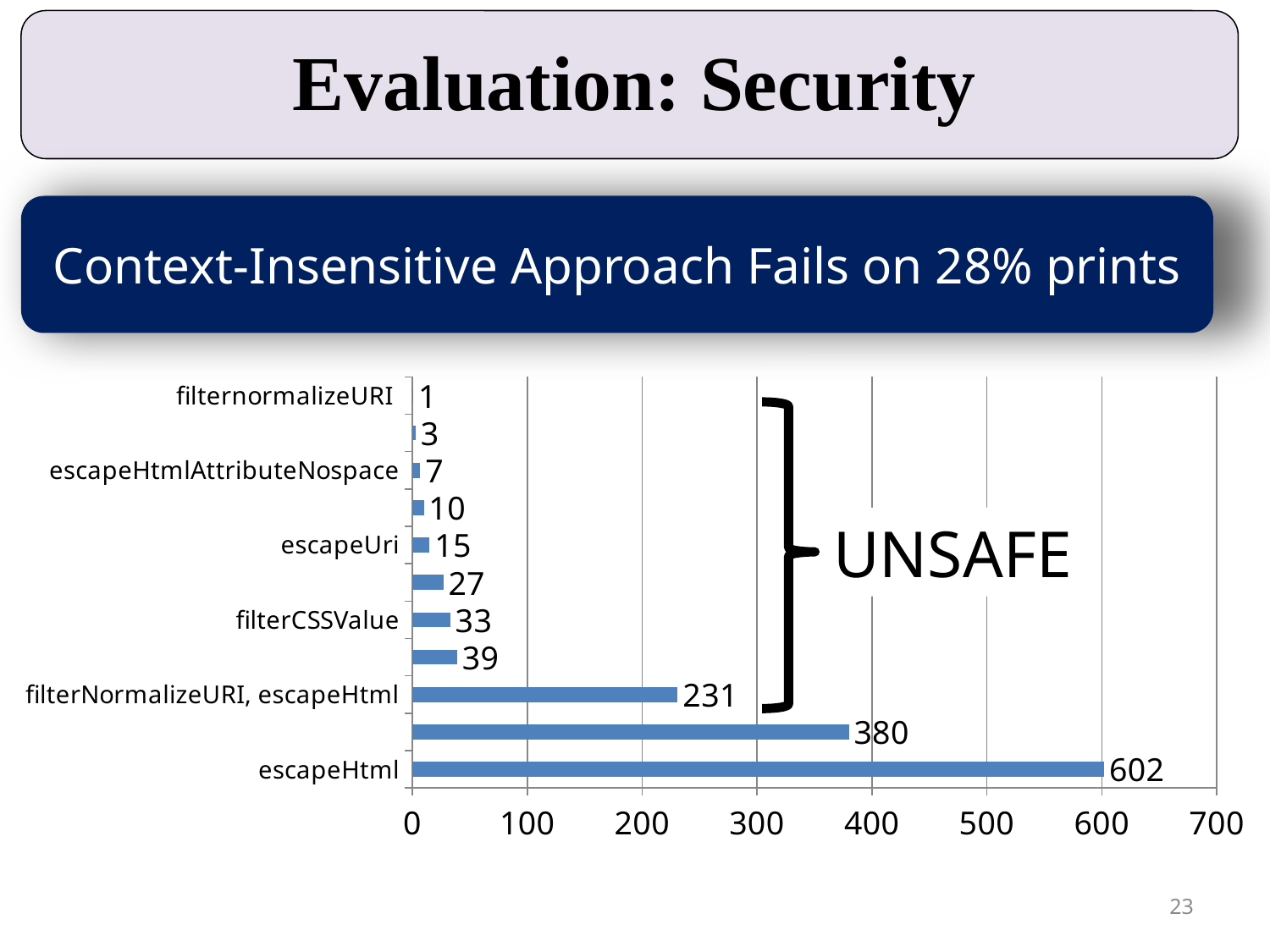
What is the difference between the values for escapeHtml and "filterNormalizeURI, escapeHtml"? 371 What is the value for escapeHtml? 602 Is the value for escapeHtml greater or less than 500? greater What kind of chart is shown on the slide? bar chart How many bars are plotted in the chart? 11 What is the value for the category labelled "filterNormalizeURI, escapeHtml"? 231 Which category has the highest value? escapeHtml What is the value for escapeUri? 15 What is the value for filterCSSValue? 33 Which category has the lowest value? filternormalizeURI Which is larger, the value for filterCSSValue or the value for escapeUri? filterCSSValue What is the value for escapeHtmlAttributeNospace? 7